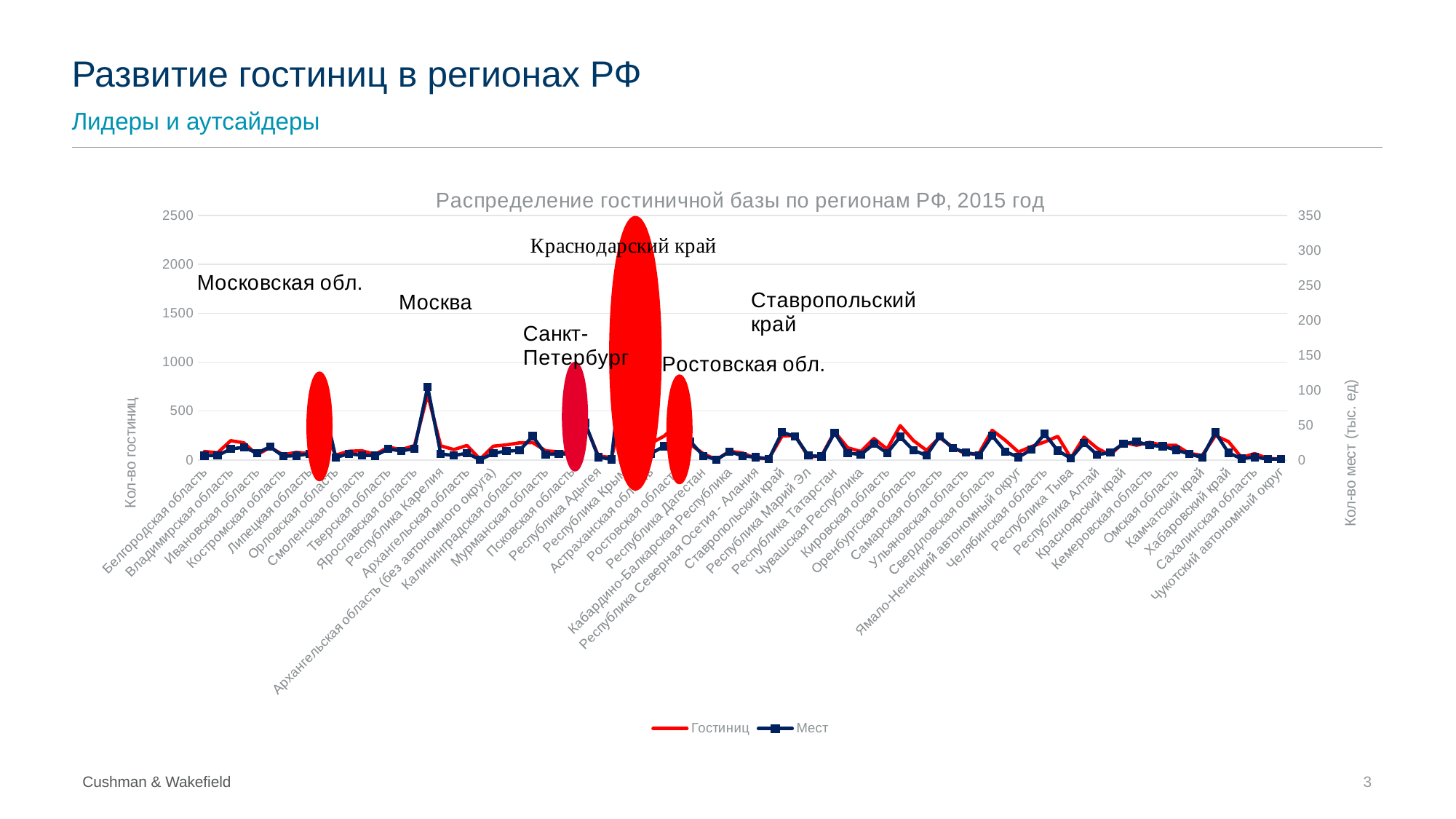
How many series does the chart's legend list? 2 What are the two series named in the chart's legend? Гостиниц and Мест Is the Мест value for Белгородская область greater or less than 100? less What is the title of the chart? Распределение гостиничной базы по регионам РФ, 2015 год What kind of chart is shown on the slide? line chart Is the Гостиниц value for Белгородская область greater or less than 500? less Is the Мест value for Чукотский автономный округ greater or less than 100? less